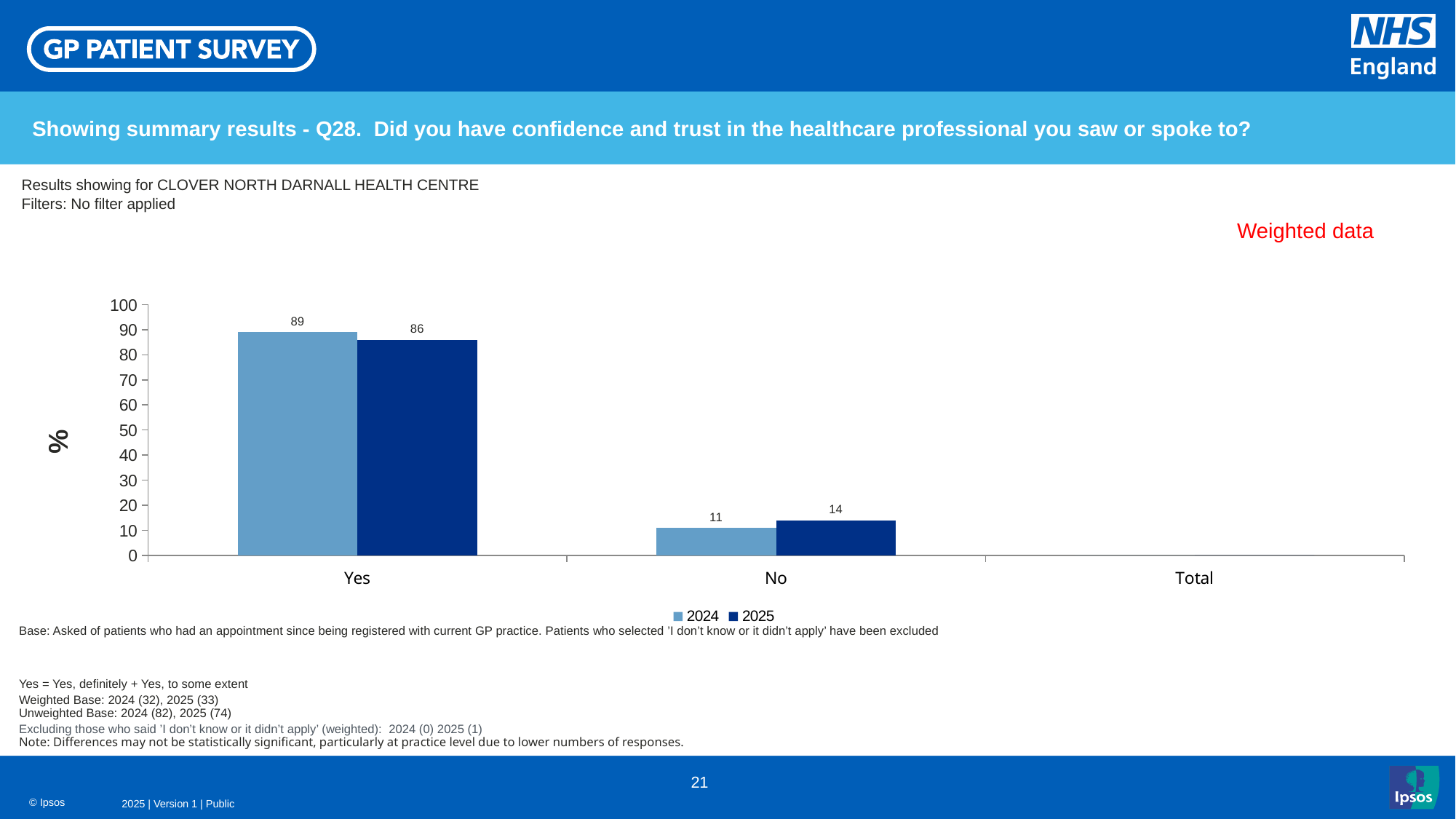
What is the value for 'Yes' in 2025? 86 What is the value for 'No' in 2024? 11 Which category has the lowest value in the 2024 series? No What is the value for 'No' in 2025? 14 What label is shown on the vertical axis? % Which category has the highest value in the 2025 series? Yes What kind of chart is shown on the slide? Bar chart What is the difference between the 2024 and 2025 values for 'Yes'? 3 What is the difference between the 2025 and 2024 values for 'No'? 3 Which is larger: the 2024 value for 'Yes' or the 2025 value for 'Yes'? 2024 What is the value for 'Yes' in 2024? 89 How many series does the legend list? 2